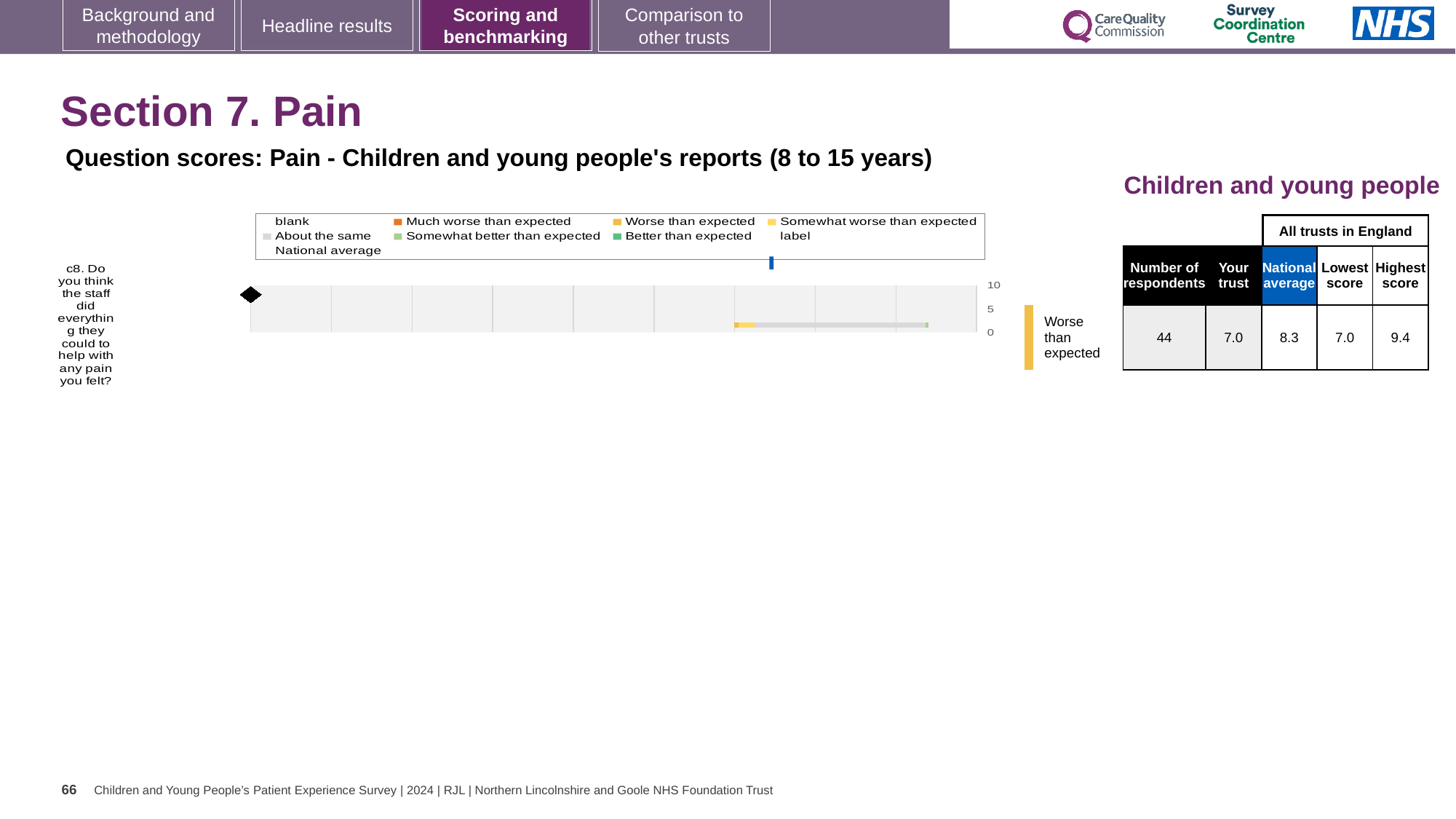
How many survey questions are plotted in the chart? 1 What is the highest score among all trusts in England for question c8? 9.4 What is the lowest score among all trusts in England for question c8? 7.0 What is the national average score for question c8? 8.3 What is the difference between the national average and the 'Your trust' score for question c8? 1.3 Which is larger for question c8, the 'Your trust' score or the national average? National average What benchmark label is shown to the right of the chart for question c8? Worse than expected What is the difference between the highest and lowest scores among all trusts in England for question c8? 2.4 How many respondents answered question c8? 44 What is the 'Your trust' score for question c8? 7.0 What kind of chart is shown on the slide for question c8? bar chart Which question is plotted in the chart? c8. Do you think the staff did everything they could to help with any pain you felt?